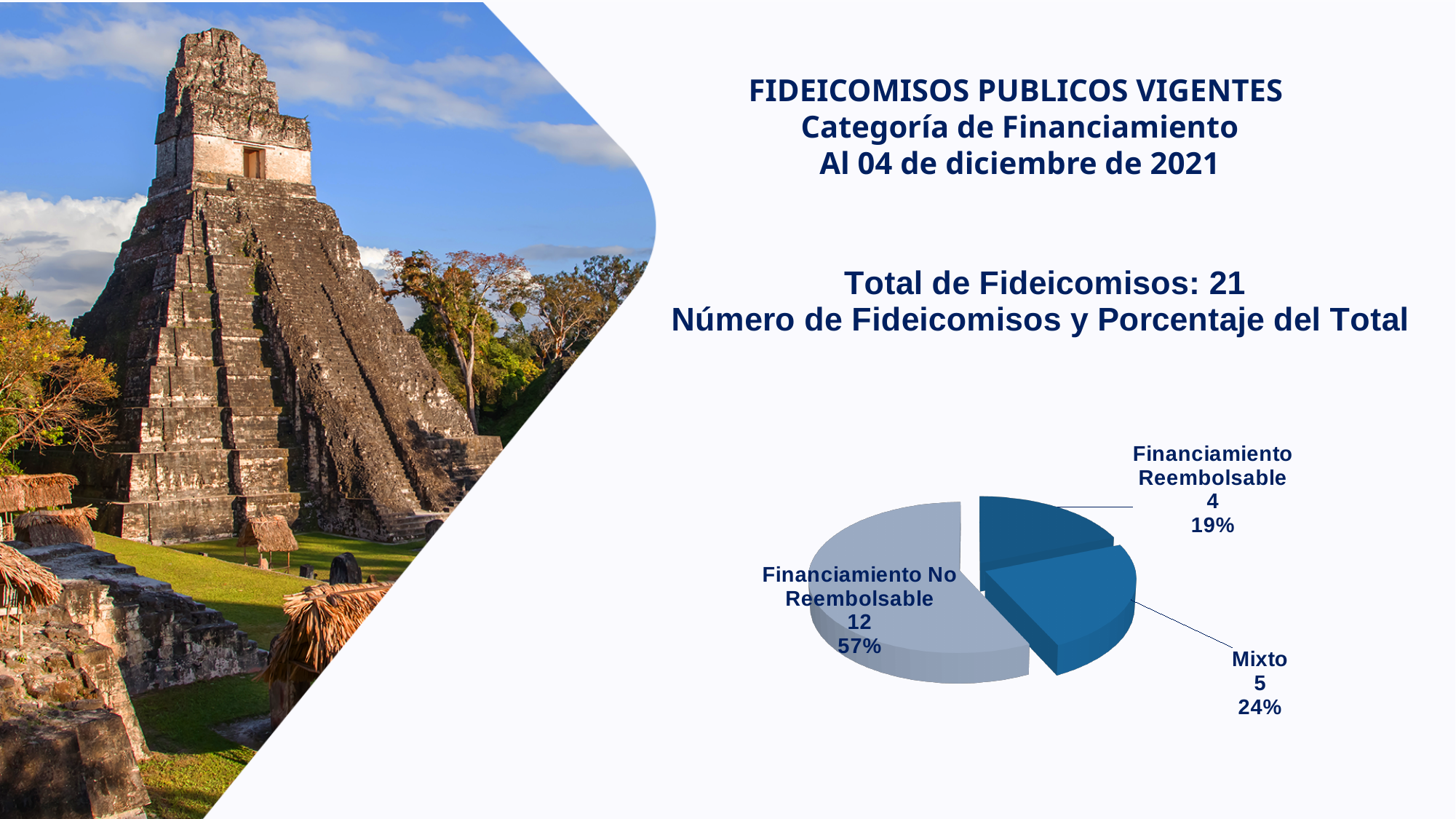
Which category has the smallest share of the pie? Financiamiento Reembolsable How many categories does the pie chart show? 3 What percentage of the total does the Mixto category represent? 24% What percentage of the total does Financiamiento Reembolsable represent? 19% What kind of chart is shown on the slide? Pie chart Which category has the largest share of the pie? Financiamiento No Reembolsable Which has more fideicomisos, Mixto or Financiamiento Reembolsable? Mixto What is the date given in the chart title? 04 de diciembre de 2021 How many fideicomisos are in the Financiamiento No Reembolsable category? 12 How many fideicomisos are in the Financiamiento Reembolsable category? 4 What is the total number of fideicomisos stated on the slide? 21 What is the difference in the number of fideicomisos between Financiamiento No Reembolsable and Mixto? 7